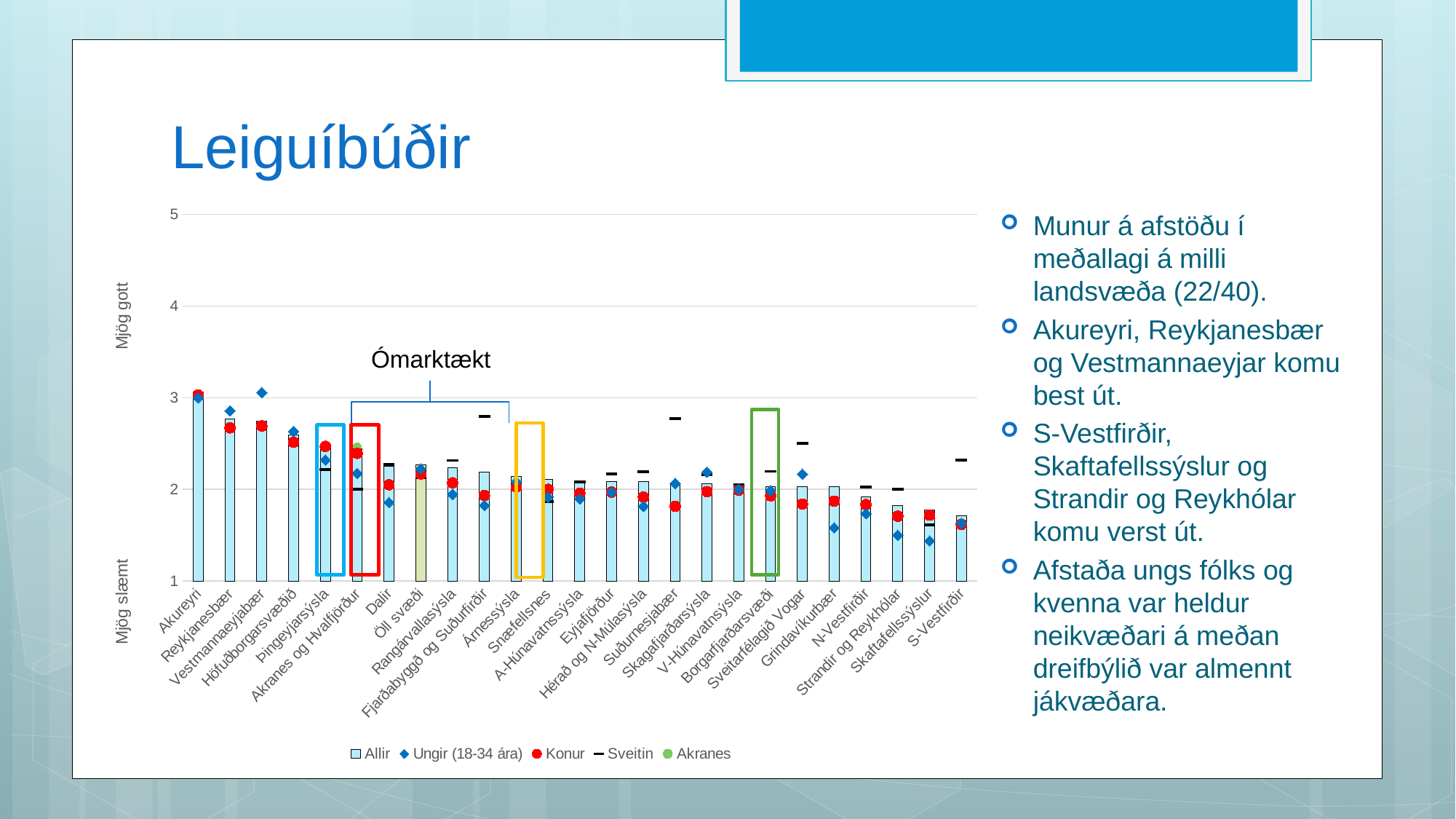
For Þingeyjarsýsla, which is larger, the Konur value or the Ungir (18-34 ára) value? Konur What label is written above the bracket spanning the middle group of bars in the chart? Ómarktækt How many categories (regions) are shown along the x axis of the chart? 25 Is the Allir value for Reykjanesbær greater or less than 3? less What kind of chart is shown on the slide? bar chart Do the Allir bars generally rise or fall from left to right along the x axis? fall Which is larger, the Allir bar for Akureyri or the Allir bar for Dalir? Akureyri Is the Allir value for Akureyri greater or less than 2? greater How many series does the chart legend list? 5 Which region has the highest Allir bar in the chart? Akureyri What is the title of the slide containing the chart? Leiguíbúðir